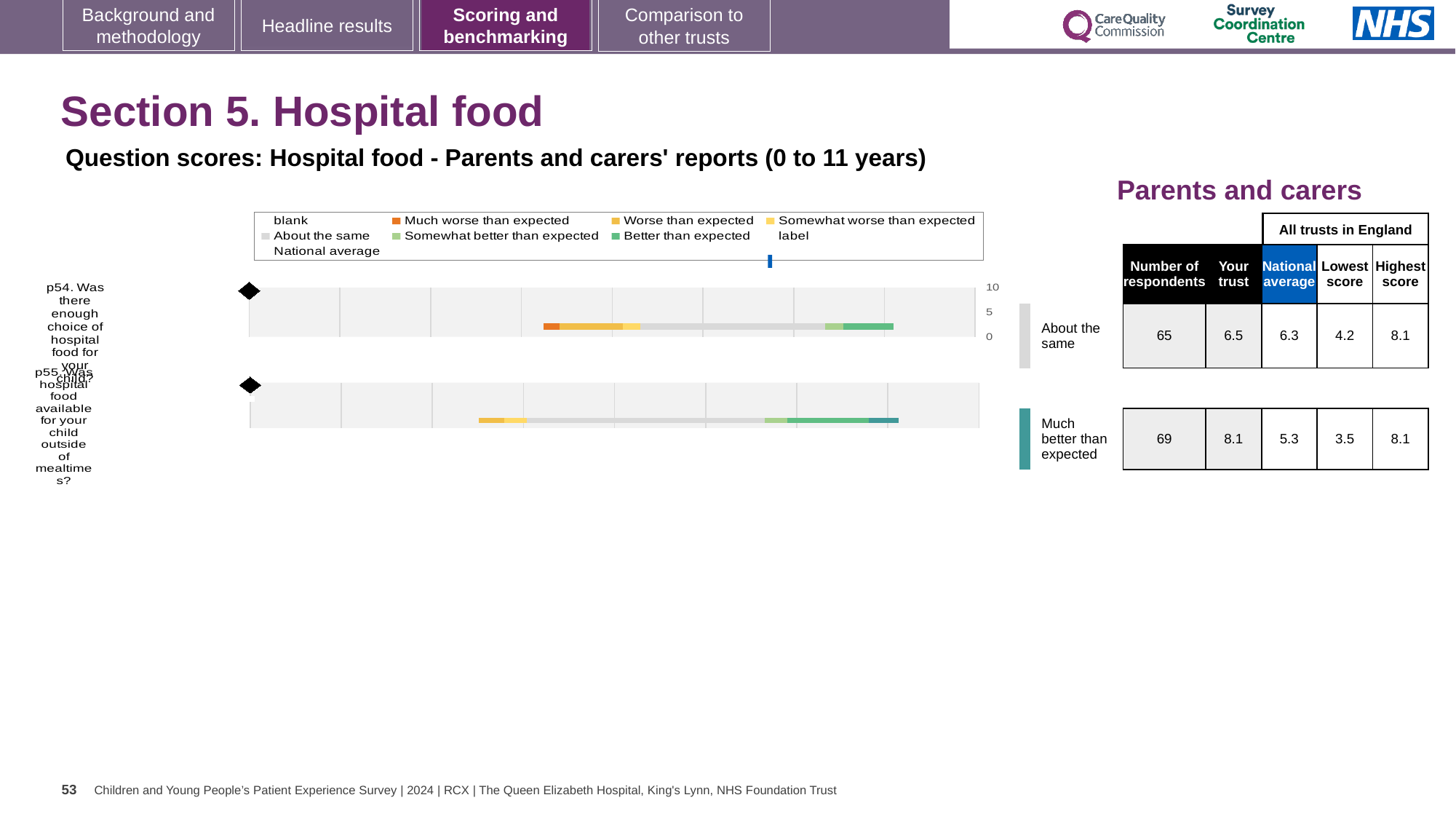
How many questions (categories) are plotted in the hospital food chart? 2 What kind of chart is used to show the question scores for hospital food? bar chart What is the 'Your trust' score for p55 (hospital food available outside of mealtimes)? 8.1 What is the highest score among all trusts in England for p54? 8.1 What is the lowest score among all trusts in England for p55? 3.5 How many respondents answered p54? 65 What is the 'Your trust' score for p54 (enough choice of hospital food for your child)? 6.5 What benchmark category is p54 rated as? About the same What is the difference between the 'Your trust' score and the national average for p55? 2.8 What is the national average score for p55? 5.3 What benchmark category is p55 rated as? Much better than expected Which question has the higher 'Your trust' score, p54 or p55? p55